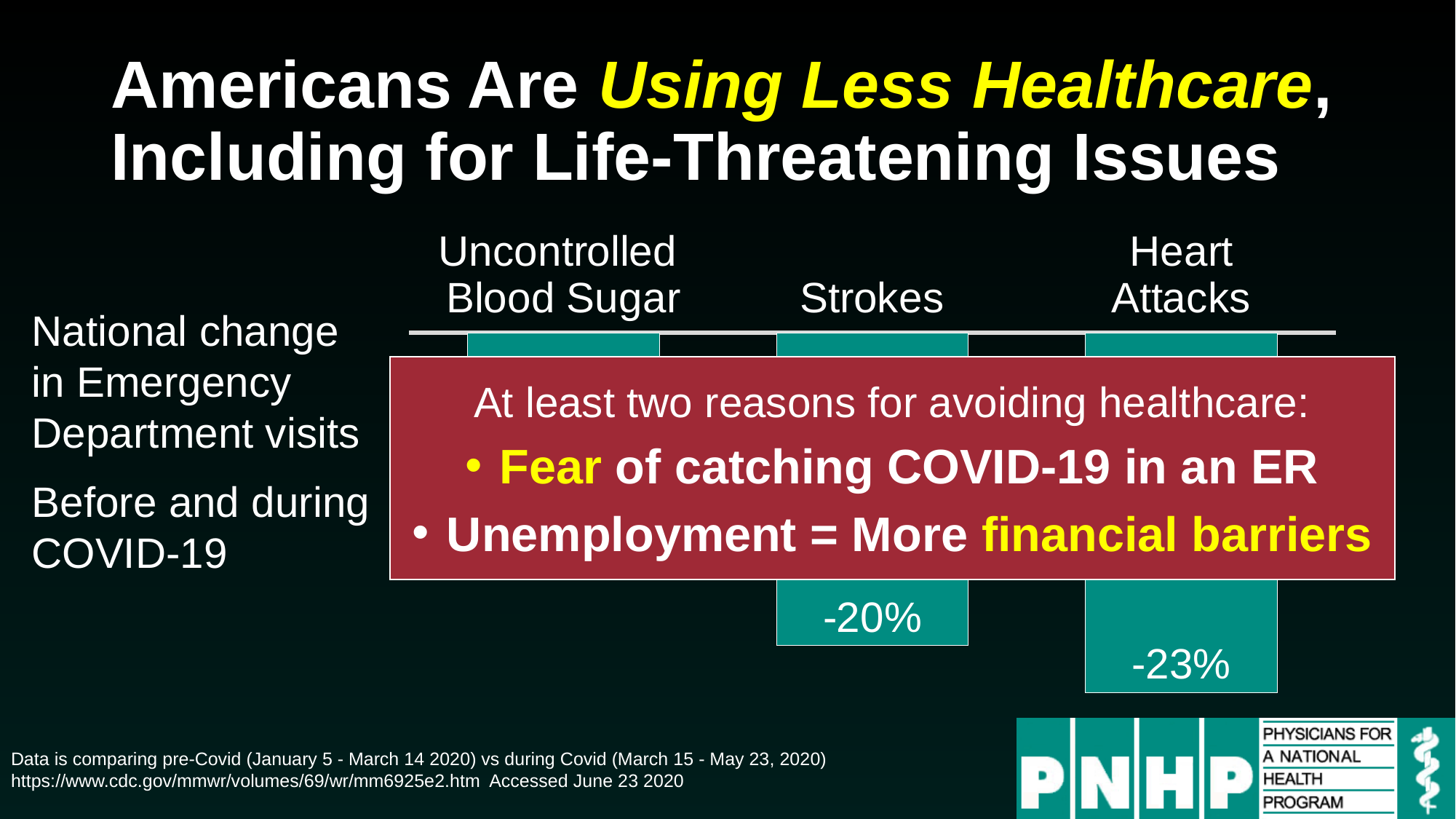
What colour are the bars in the chart? Teal Which has a larger decline in Emergency Department visits, Uncontrolled Blood Sugar or Strokes? Strokes What is the value shown for Strokes? -20% By how many percentage points does the decline for Heart Attacks exceed the decline for Strokes? 3 percentage points What is the value shown for Heart Attacks? -23% Do the declines get larger or smaller moving from left to right across the categories? Larger Which category shows the smallest decline in Emergency Department visits? Uncontrolled Blood Sugar What kind of chart is shown on the slide? Bar chart How many categories are shown in the chart? 3 Which has a larger decline in Emergency Department visits, Strokes or Heart Attacks? Heart Attacks What does the chart measure, according to the text to its left? National change in Emergency Department visits before and during COVID-19 Which category shows the largest decline in Emergency Department visits? Heart Attacks